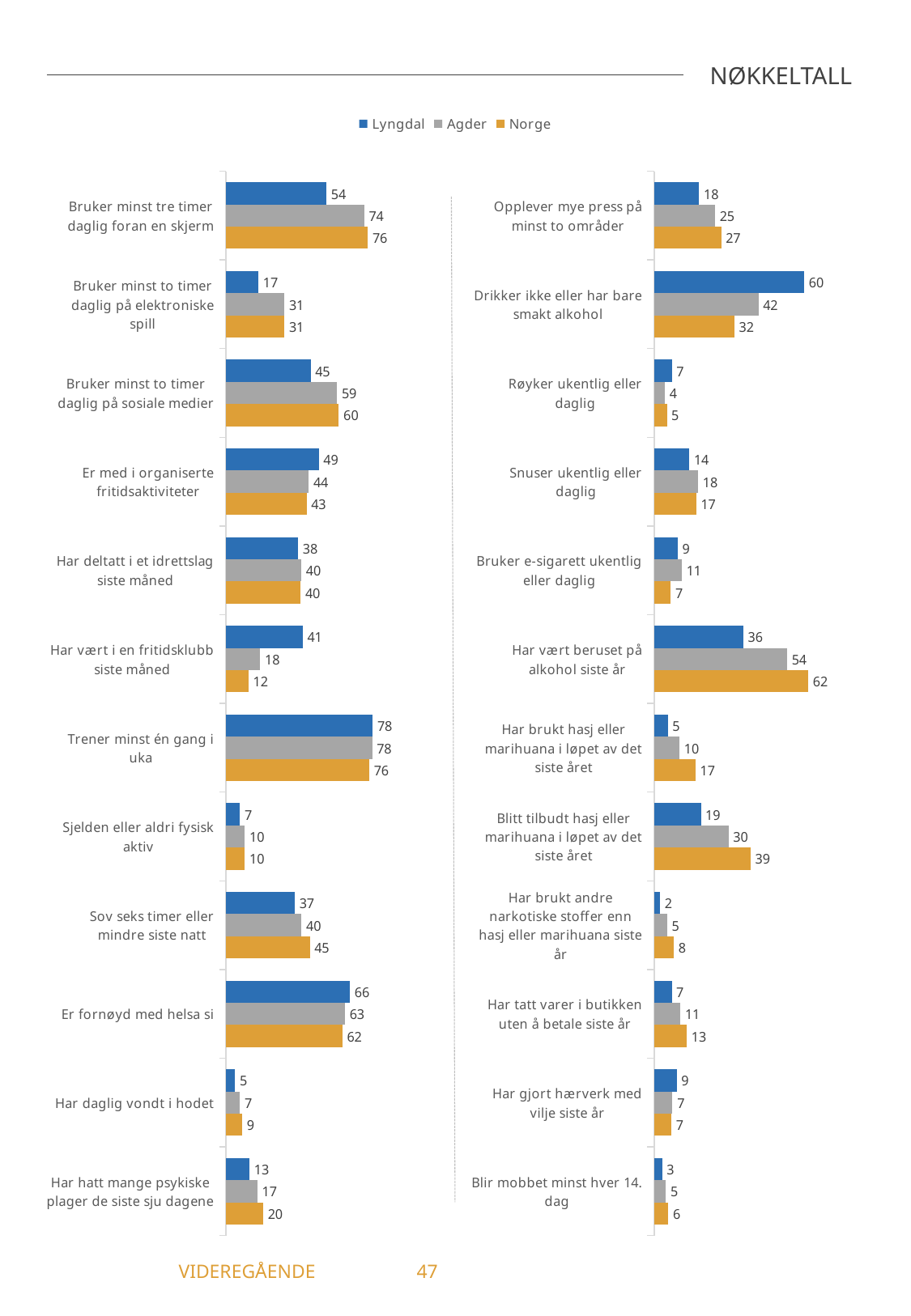
In the left chart, what is the Lyngdal value for "Bruker minst tre timer daglig foran en skjerm"? 54 How many categories are shown in the left chart? 12 How many series does the legend list? 3 In the left chart, what is the difference between the Norge and Lyngdal values for "Bruker minst tre timer daglig foran en skjerm"? 22 In the right chart, what is the Agder value for "Blitt tilbudt hasj eller marihuana i løpet av det siste året"? 30 What kind of chart is used on this slide? Bar chart In the right chart, which category has the lowest Lyngdal value? Har brukt andre narkotiske stoffer enn hasj eller marihuana siste år In the right chart, what is the difference between the Lyngdal and Norge values for "Drikker ikke eller har bare smakt alkohol"? 28 In the left chart, for "Har vært i en fritidsklubb siste måned", which is larger: the Lyngdal value or the Norge value? Lyngdal In the right chart, for "Har vært beruset på alkohol siste år", which is larger: the Lyngdal value or the Agder value? Agder In the left chart, which category has the highest Lyngdal value? Trener minst én gang i uka In the right chart, what is the Norge value for "Har vært beruset på alkohol siste år"? 62